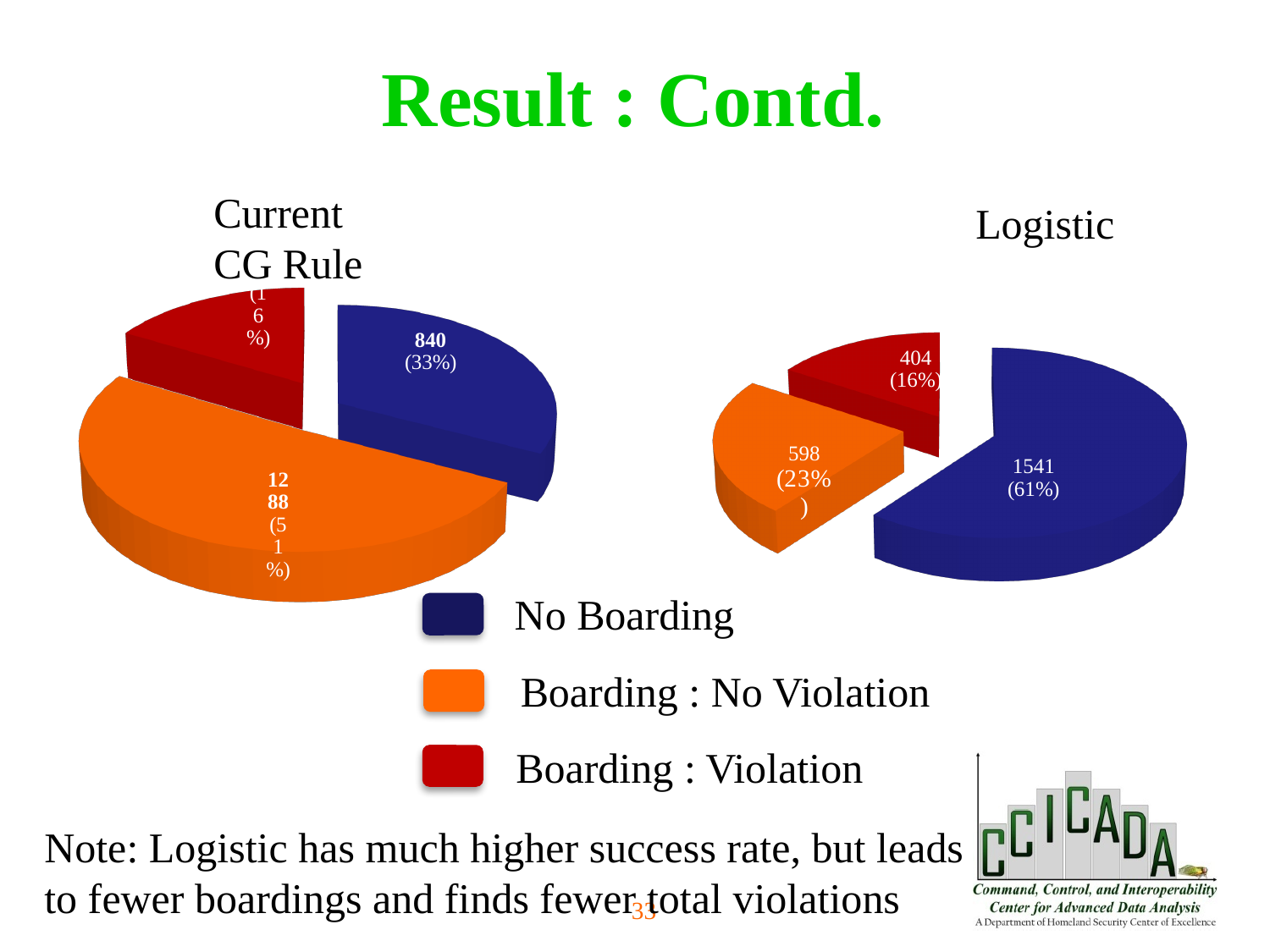
Which chart has the larger No Boarding value, Current CG Rule or Logistic? Logistic How many categories does the legend list for the pie charts? 3 In the Logistic pie chart, what is the value for No Boarding? 1541 In the Logistic pie chart, what share of the pie is Boarding : Violation? 16% In the Logistic pie chart, which category has the largest slice? No Boarding In the Logistic pie chart, what is the value for Boarding : No Violation? 598 In the Logistic pie chart, what is the difference between the No Boarding value and the Boarding : No Violation value? 943 In the Current CG Rule pie chart, what is the value for Boarding : No Violation? 1288 In the Logistic pie chart, which category has the smallest slice? Boarding : Violation In the Current CG Rule pie chart, which category has the largest slice? Boarding : No Violation What kind of chart is used for the Current CG Rule and Logistic results? Pie chart In the Current CG Rule pie chart, what share of the pie is No Boarding? 33%